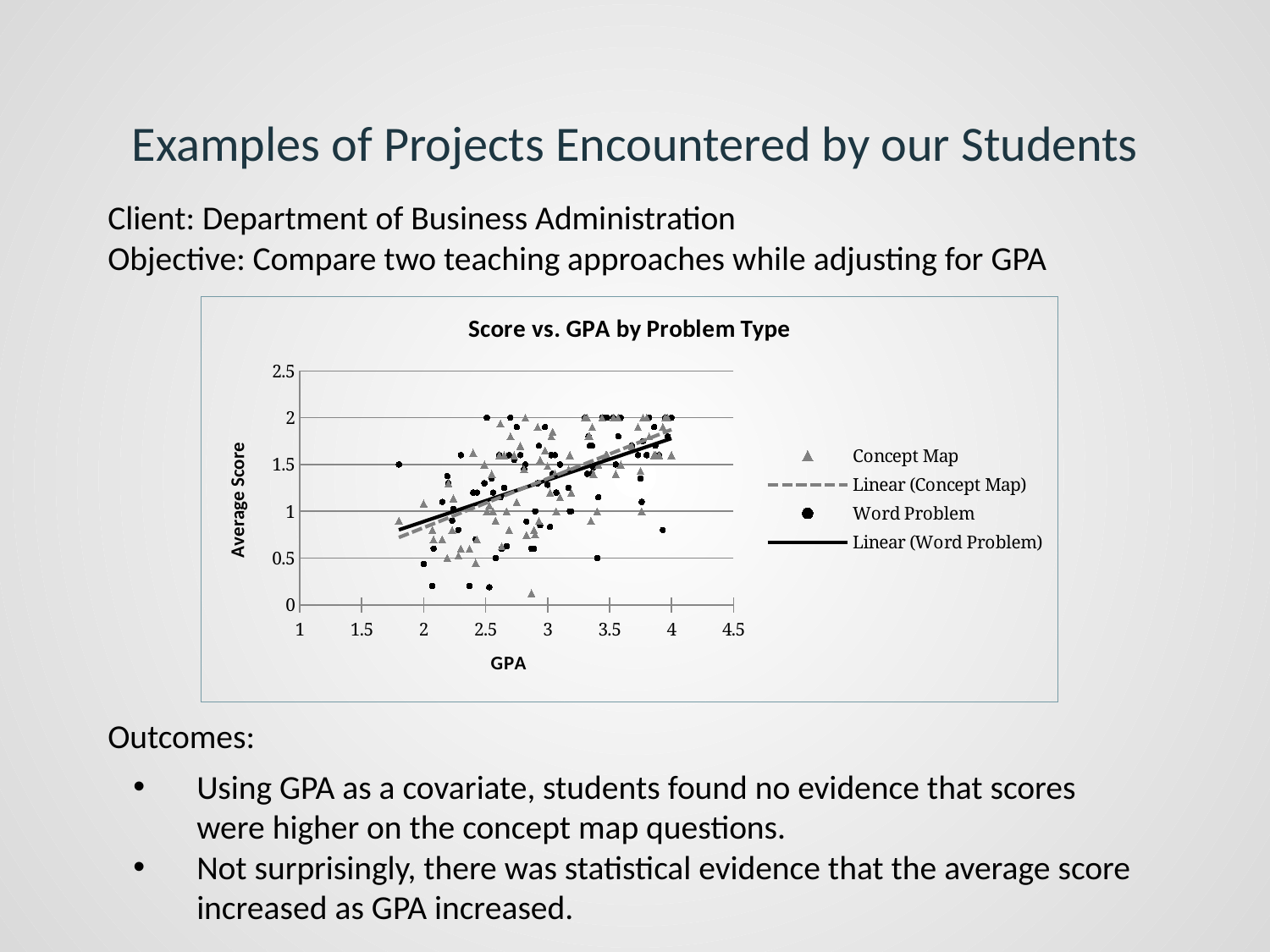
How many entries does the chart's legend list? 4 What is the label on the chart's vertical axis? Average Score Which legend entry is drawn as a dashed line? Linear (Concept Map) What is the label on the chart's horizontal axis? GPA Do the fitted trend lines show average score rising or falling as GPA increases? Rising What kind of chart is shown on the slide? Scatter chart